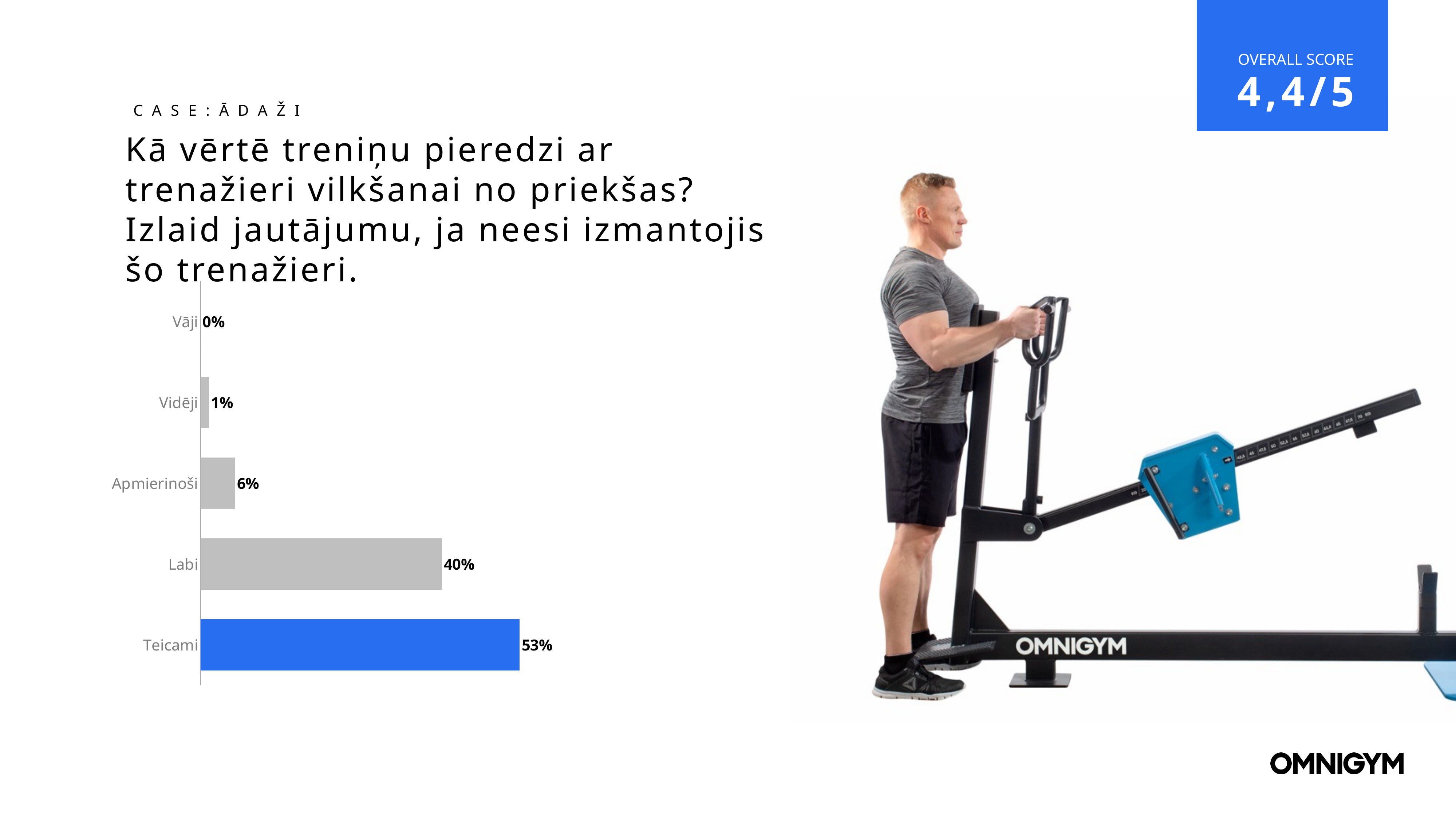
What percentage of respondents rated the experience as Teicami? 53% What is the value shown for Vidēji? 1% How many categories are shown in the chart? 5 Which category has the highest value? Teicami What is the value shown for Vāji? 0% What is the value shown for Labi? 40% What is the difference between the values for Teicami and Labi? 13% What is the value shown for Apmierinoši? 6% What kind of chart is shown on the slide? Bar chart Which is larger, the value for Apmierinoši or the value for Vidēji? Apmierinoši Which category has the lowest value? Vāji Which bar is coloured blue rather than grey? Teicami